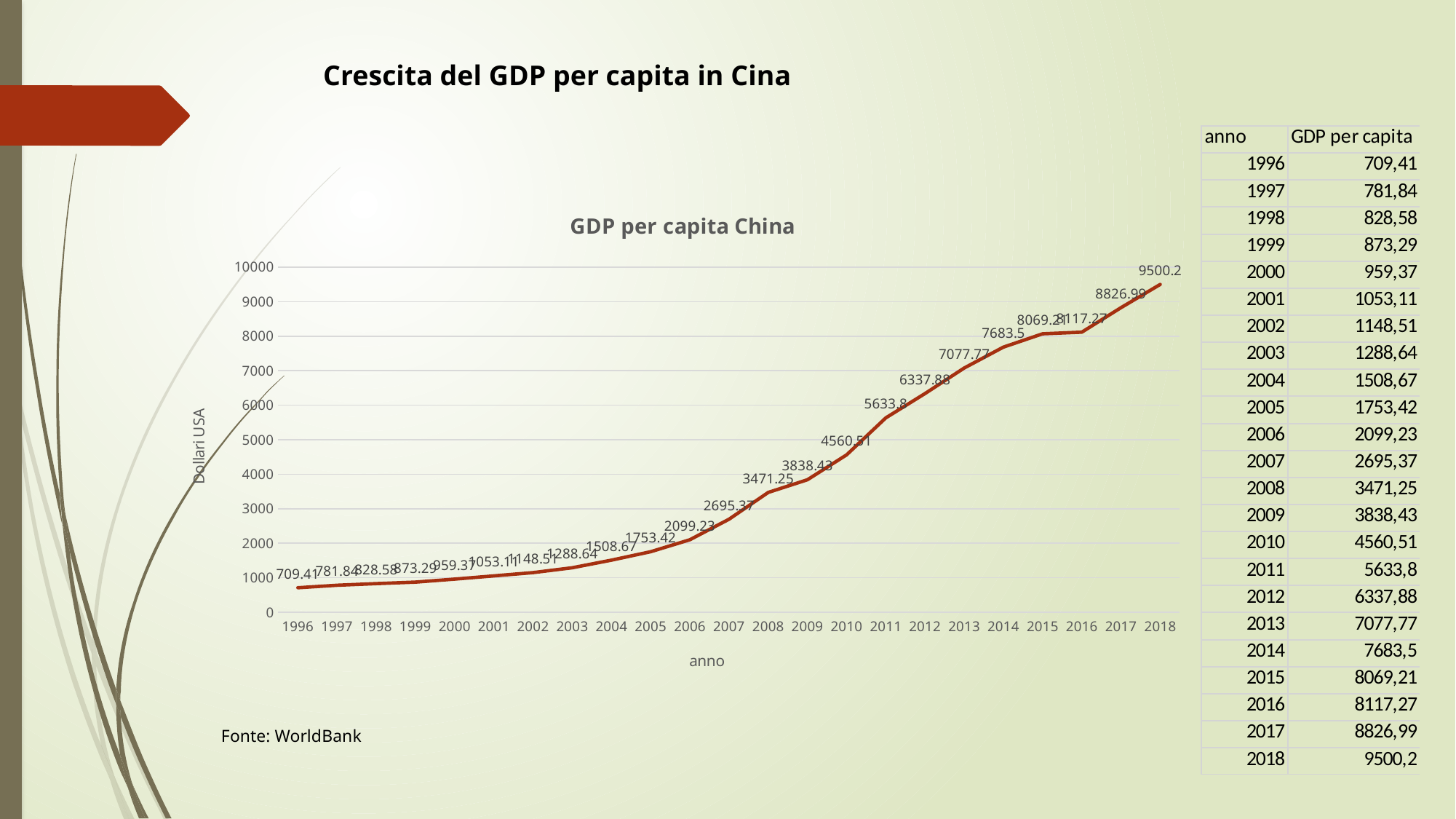
Which year has the lowest GDP per capita in the chart? 1996 Is the GDP per capita value for 2005 greater or less than 2000? greater Does GDP per capita rise or fall from 1996 to 2018? rise What is the difference between the GDP per capita values for 2008 and 2007? 775.88 What is the GDP per capita value shown for 2018? 9500.2 What is the GDP per capita value shown for 2010? 4560.51 What kind of chart is used to show GDP per capita China? line chart How many years are plotted on the x axis of the chart? 23 What is the GDP per capita value shown for 2000? 959.37 Which year has the highest GDP per capita in the chart? 2018 What is the difference between the GDP per capita values for 2018 and 2017? 673.21 Which year has a larger GDP per capita, 2011 or 2012? 2012